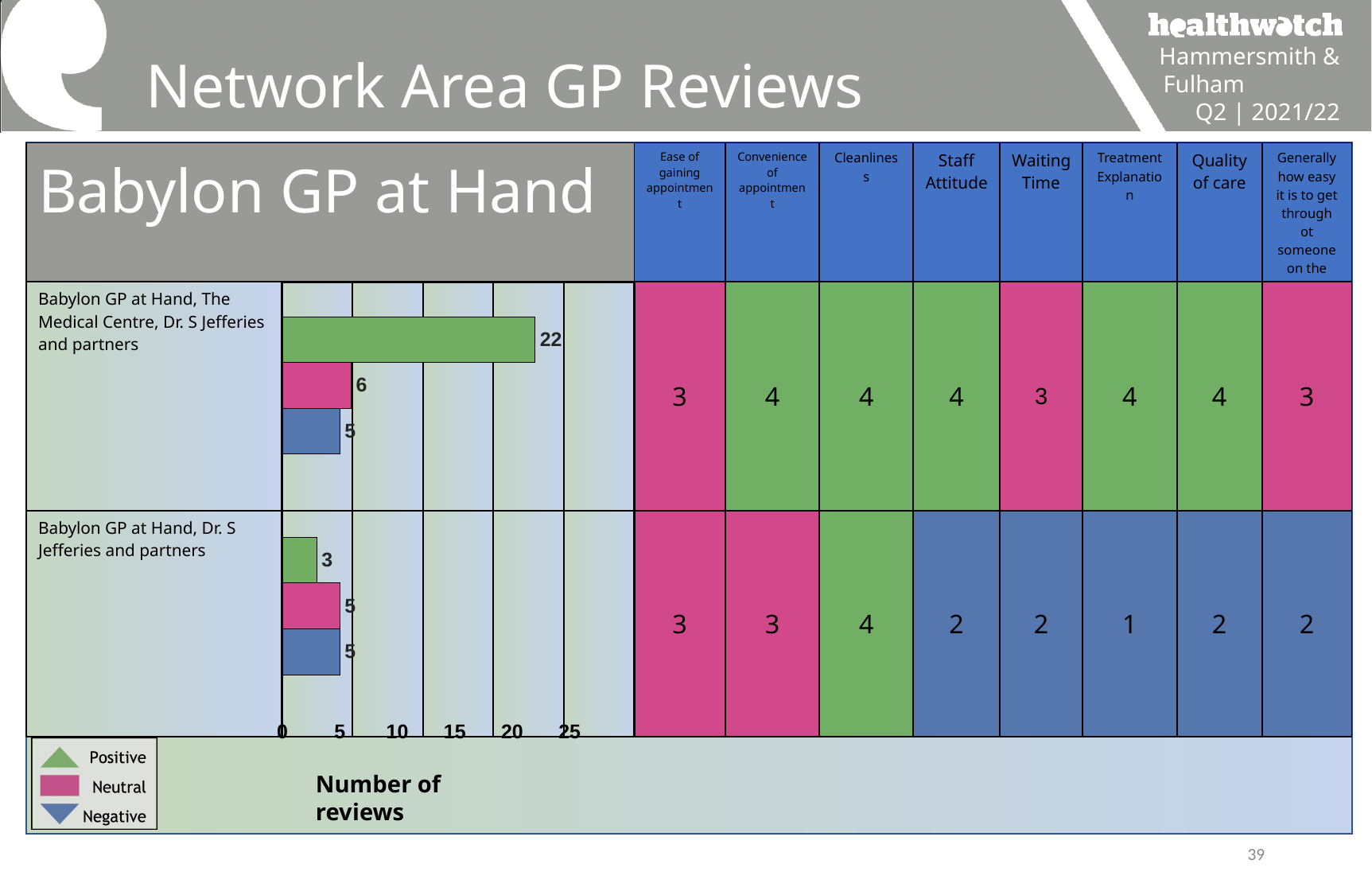
How many positive reviews did Babylon GP at Hand, The Medical Centre, Dr. S Jefferies and partners receive? 22 How many positive reviews did Babylon GP at Hand, Dr. S Jefferies and partners receive? 3 How many neutral reviews did Babylon GP at Hand, The Medical Centre, Dr. S Jefferies and partners receive? 6 How many series does the legend of the reviews chart list? 3 Which is larger for Babylon GP at Hand, Dr. S Jefferies and partners: positive reviews or neutral reviews? neutral reviews What is the total number of reviews for Babylon GP at Hand, The Medical Centre, Dr. S Jefferies and partners? 33 What kind of chart is used to show the number of reviews? bar chart What is the difference between the positive reviews of the two practices? 19 Which colour represents negative reviews in the chart legend? blue Is the number of positive reviews for Babylon GP at Hand, The Medical Centre, Dr. S Jefferies and partners greater or less than 20? greater How many negative reviews did Babylon GP at Hand, Dr. S Jefferies and partners receive? 5 Which practice has the highest number of positive reviews? Babylon GP at Hand, The Medical Centre, Dr. S Jefferies and partners